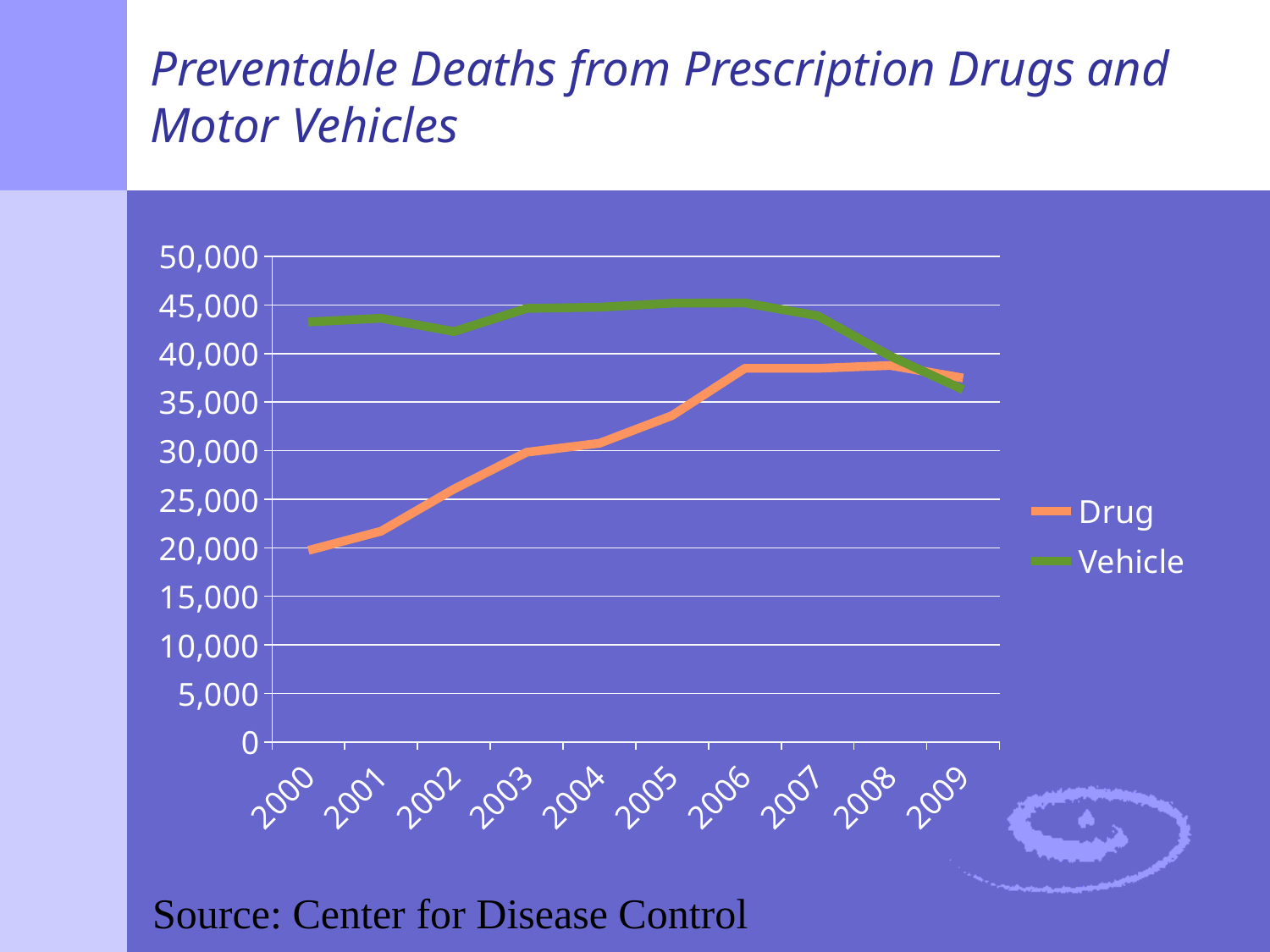
Is the value for Vehicle in 2005 greater or less than 40,000? greater What kind of chart is shown on the slide? Line chart How many series does the legend list? 2 How many years are shown on the x axis? 10 Which series is shown in green in the legend? Vehicle Is the value for Vehicle in 2002 greater or less than 45,000? less In which year is the Drug series at its lowest? 2000 Is the value for Drug in 2001 greater or less than 20,000? greater In which year is the Vehicle series at its lowest? 2009 In 2005, which series has the larger value, Drug or Vehicle? Vehicle